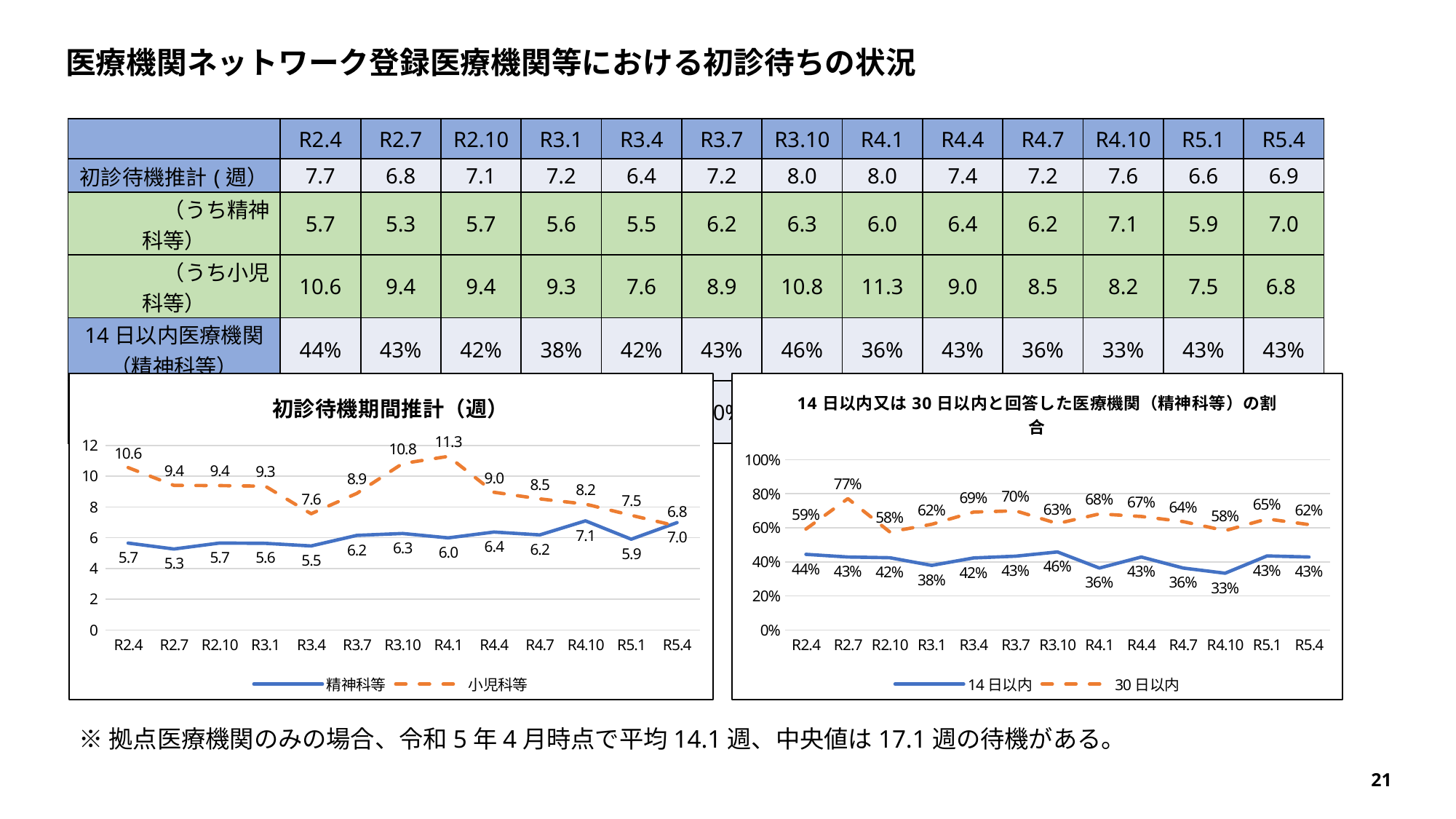
In the left chart titled 初診待機期間推計（週）, how many periods are shown on the x axis? 13 In the right chart about 14日以内又は30日以内と回答した医療機関（精神科等）の割合, at which period is the 14日以内 value lowest? R4.10 In the right chart about 14日以内又は30日以内と回答した医療機関（精神科等）の割合, what is the difference between 30日以内 and 14日以内 at R4.1? 32% What kind of chart is the left chart titled 初診待機期間推計（週）? Line chart In the left chart titled 初診待機期間推計（週）, what is the value for 小児科等 at R4.1? 11.3 In the left chart titled 初診待機期間推計（週）, how many series does the legend list? 2 In the left chart titled 初診待機期間推計（週）, at which period is the 小児科等 value lowest? R5.4 In the left chart titled 初診待機期間推計（週）, what is the difference between 小児科等 and 精神科等 at R2.4? 4.9 In the right chart about 14日以内又は30日以内と回答した医療機関（精神科等）の割合, which is larger at R3.10: 14日以内 or 30日以内? 30日以内 In the right chart about 14日以内又は30日以内と回答した医療機関（精神科等）の割合, what is the value for 30日以内 at R2.7? 77% In the left chart titled 初診待機期間推計（週）, what is the value for 精神科等 at R4.10? 7.1 In the right chart about 14日以内又は30日以内と回答した医療機関（精神科等）の割合, which series is drawn with a dashed orange line? 30日以内